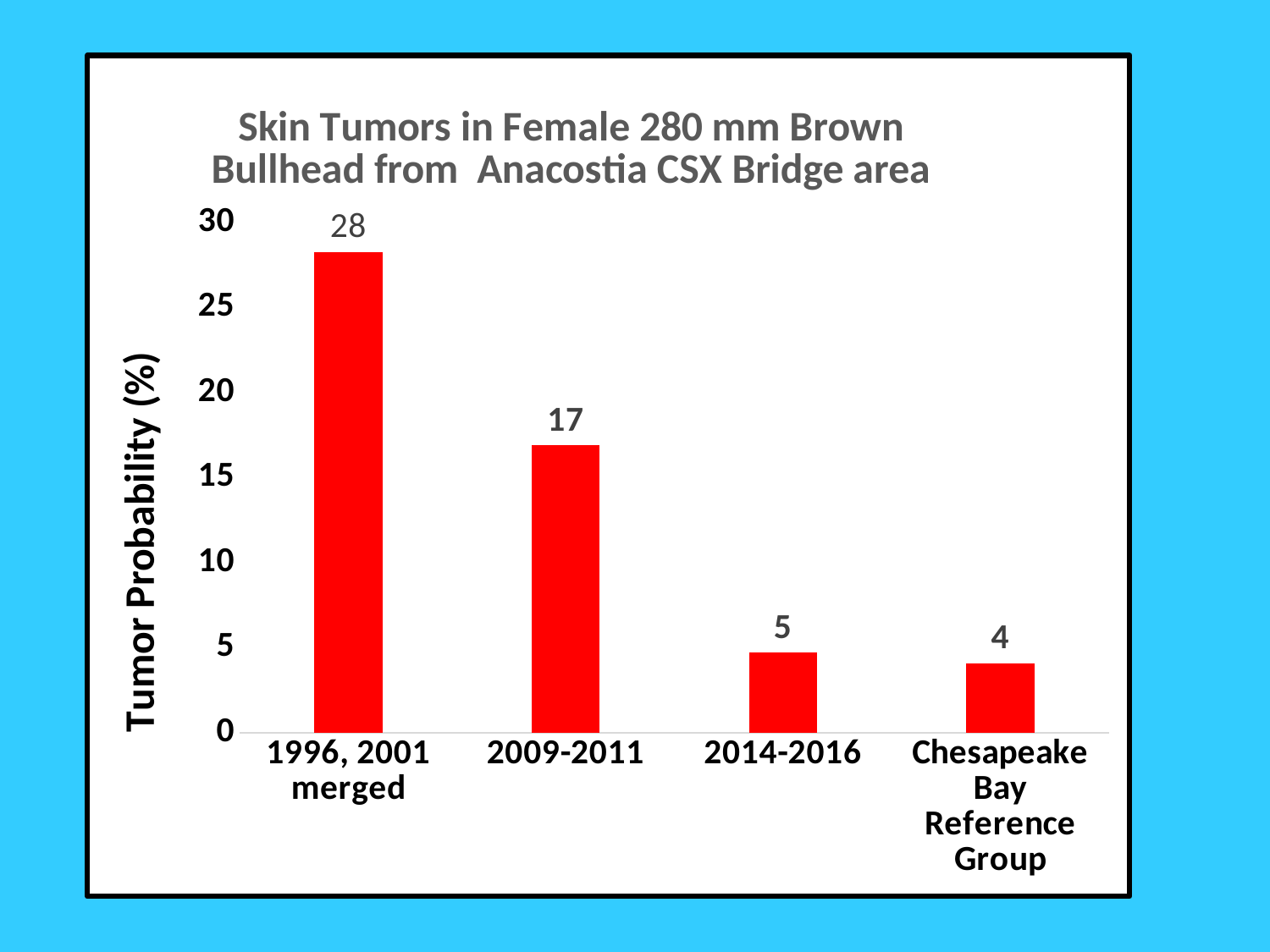
What is the tumor probability for 2009-2011? 17 Which category has the lowest tumor probability? Chesapeake Bay Reference Group How many categories are shown on the x axis? 4 What is the label of the y axis? Tumor Probability (%) Which category has the highest tumor probability? 1996, 2001 merged Which has a higher tumor probability, 2009-2011 or 2014-2016? 2009-2011 What is the tumor probability for the Chesapeake Bay Reference Group? 4 What is the tumor probability for 2014-2016? 5 What is the difference in tumor probability between 1996, 2001 merged and 2009-2011? 11 What kind of chart is shown on the slide? Bar chart What is the difference in tumor probability between 2014-2016 and the Chesapeake Bay Reference Group? 1 What is the tumor probability for the 1996, 2001 merged group? 28